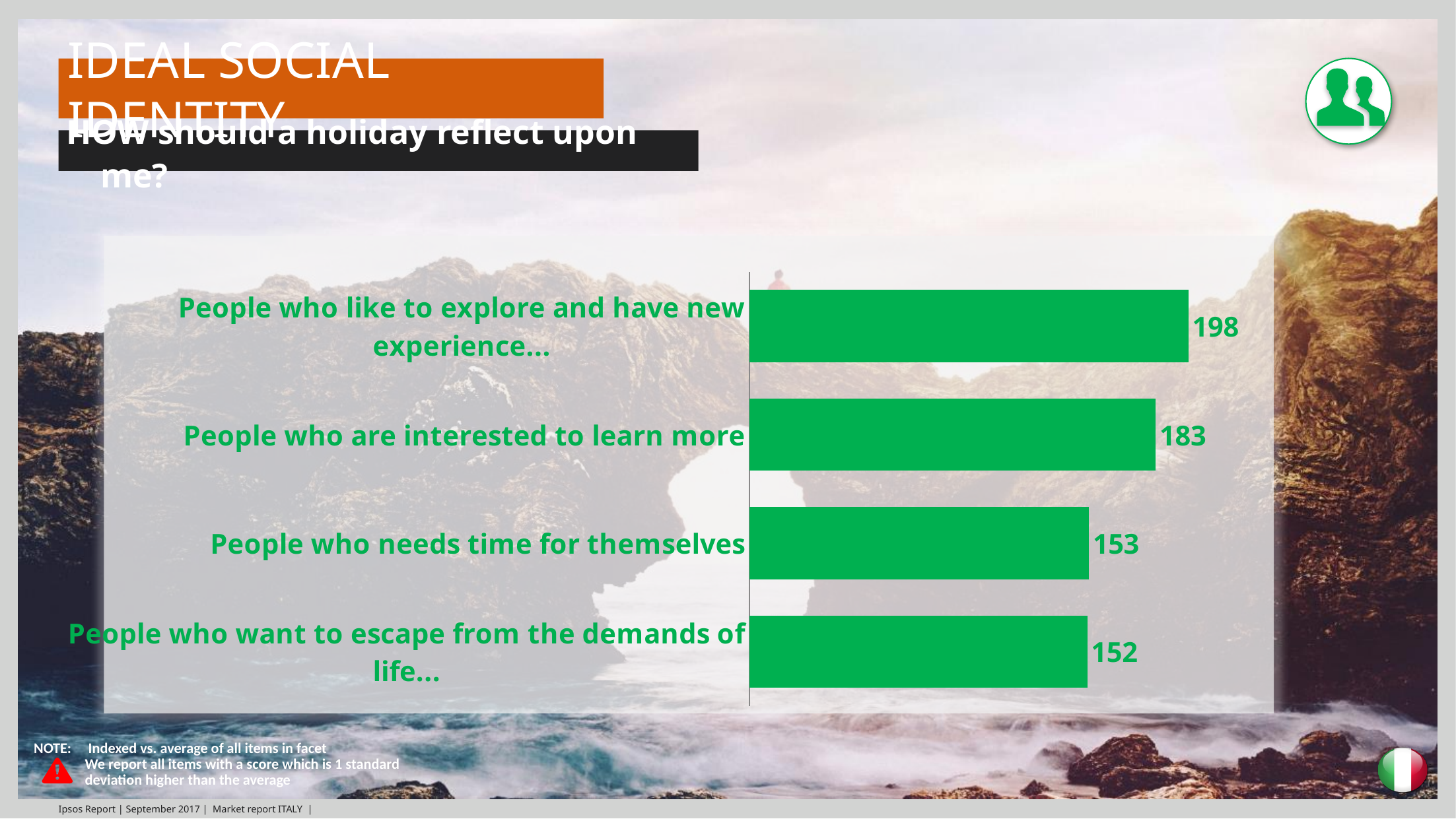
What is the value for "People who like to explore and have new experience..."? 198 Which is larger: the value for "People who are interested to learn more" or "People who needs time for themselves"? People who are interested to learn more What colour are the bars in the chart? Green How many categories are shown in the chart? 4 What is the difference between the values for "People who like to explore and have new experience..." and "People who are interested to learn more"? 15 What is the value for "People who are interested to learn more"? 183 What is the difference between the values for "People who are interested to learn more" and "People who needs time for themselves"? 30 What is the value for "People who needs time for themselves"? 153 Which category has the highest value? People who like to explore and have new experience... Which category has the lowest value? People who want to escape from the demands of life... What is the value for "People who want to escape from the demands of life..."? 152 What kind of chart is shown on the slide? Bar chart